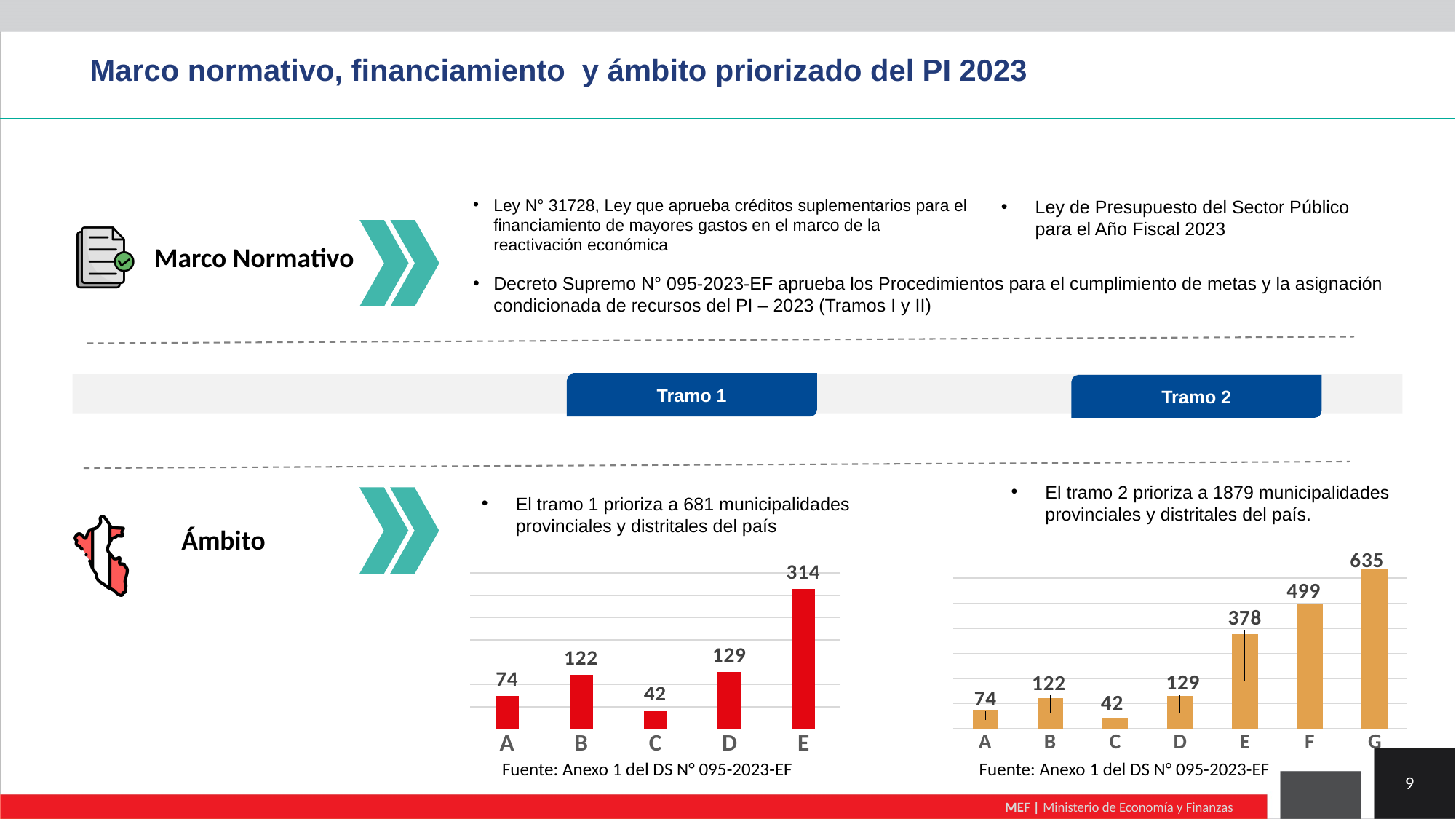
In the right chart (Tramo 2), which is larger, the value for E or the value for F? F In the left chart (Tramo 1), which category has the lowest value? C What colour are the bars in the left chart (Tramo 1)? red In the right chart (Tramo 2), which category has the highest value? G In the right chart (Tramo 2), what is the value for category F? 499 In the left chart (Tramo 1), what kind of chart is shown? bar chart In the left chart (Tramo 1), what is the value for category E? 314 In the left chart (Tramo 1), how many categories are shown on the x axis? 5 In the left chart (Tramo 1), what is the difference between the values for E and D? 185 In the right chart (Tramo 2), what is the difference between the values for G and F? 136 In the right chart (Tramo 2), how many categories are shown on the x axis? 7 In the right chart (Tramo 2), what is the value for category G? 635